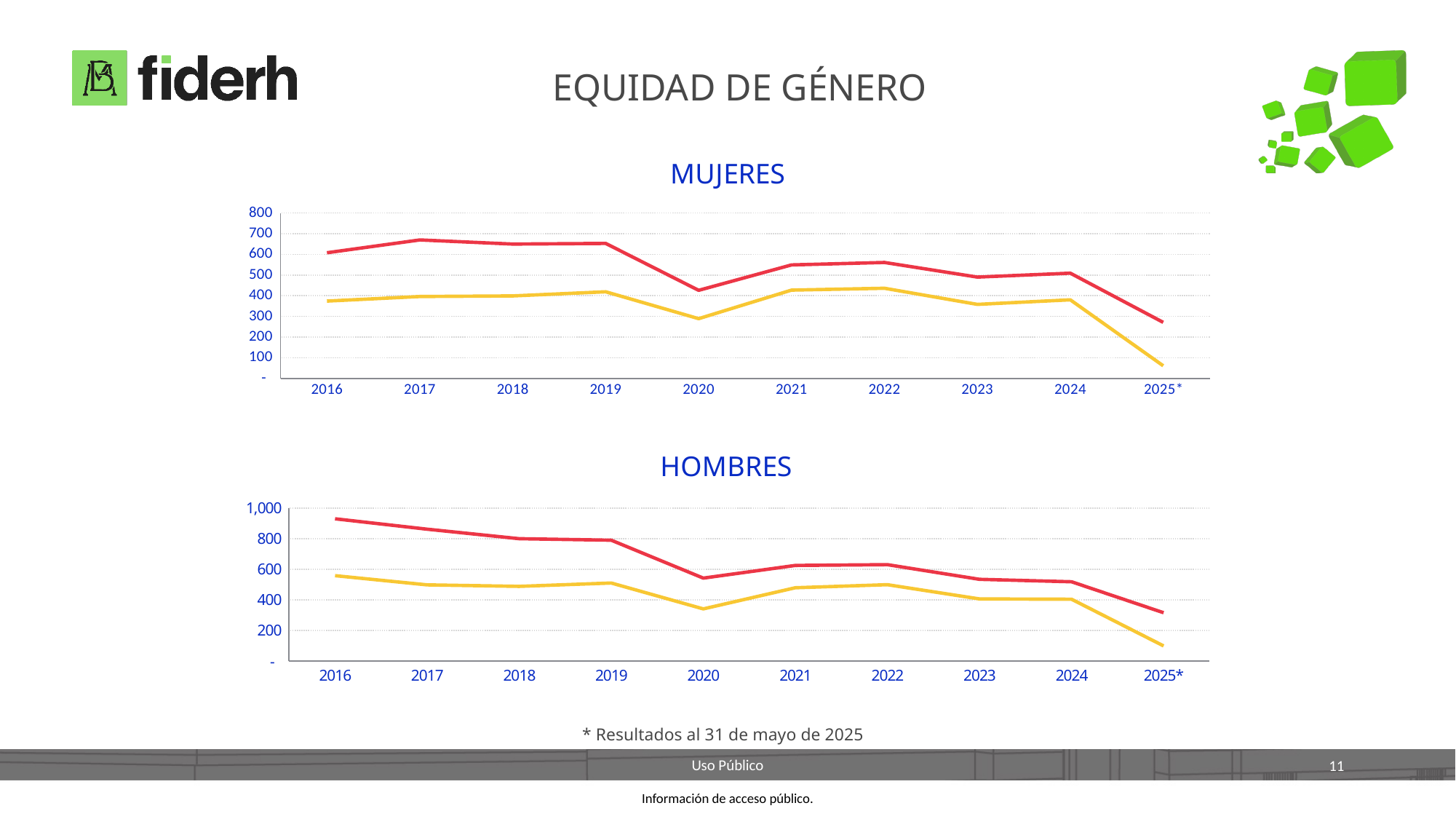
In the MUJERES chart, is the red line's value for 2016 greater or less than 500? greater In the MUJERES chart, in which year does the red line reach its highest value? 2017 In the HOMBRES chart, do the values of the red line generally rise or fall from 2016 to 2025*? fall In the HOMBRES chart, is the yellow line's value for 2020 greater or less than 400? less What is the title of the lower chart on the slide? HOMBRES In the MUJERES chart, is the yellow line's value for 2025* greater or less than 100? less What kind of chart is the MUJERES chart? line chart In the HOMBRES chart, in which year does the red line reach its highest value? 2016 In the HOMBRES chart, which line is higher in 2022, the red line or the yellow line? the red line In the MUJERES chart, in which year does the yellow line reach its lowest value? 2025* How many years are shown on the x axis of the HOMBRES chart? 10